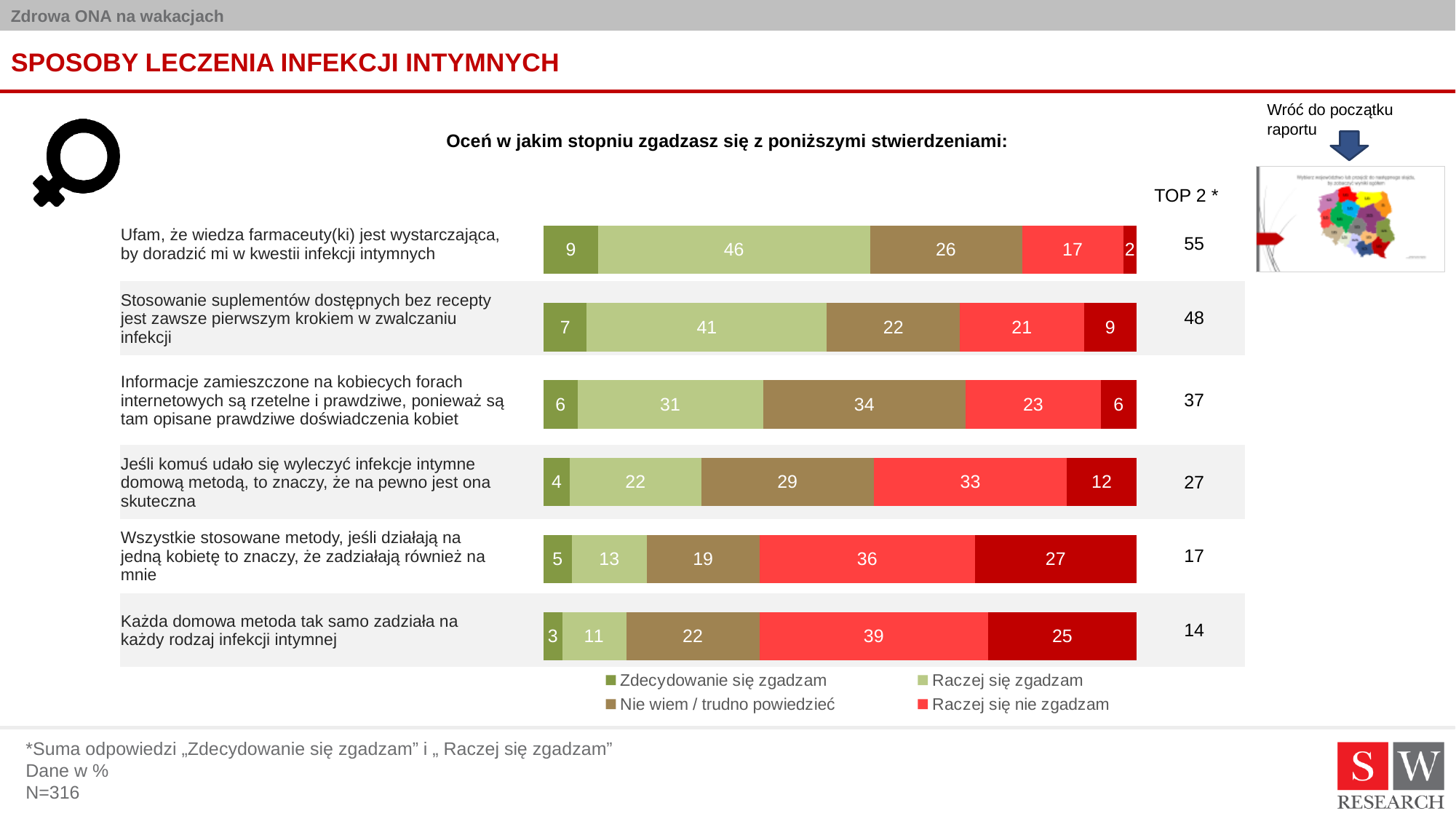
How many statements (categories) are plotted in the chart? 6 What is the 'Raczej się zgadzam' value for the statement 'Ufam, że wiedza farmaceuty(ki) jest wystarczająca, by doradzić mi w kwestii infekcji intymnych'? 46 What is the difference between the TOP 2 values of 'Ufam, że wiedza farmaceuty(ki)...' and 'Każda domowa metoda tak samo zadziała...'? 41 Which statement has the highest TOP 2 value? Ufam, że wiedza farmaceuty(ki) jest wystarczająca, by doradzić mi w kwestii infekcji intymnych What is the TOP 2 value for the statement 'Stosowanie suplementów dostępnych bez recepty jest zawsze pierwszym krokiem w zwalczaniu infekcji'? 48 What is the question shown as the chart title above the bars? Oceń w jakim stopniu zgadzasz się z poniższymi stwierdzeniami: What is the total of all segments in the bar for 'Jeśli komuś udało się wyleczyć infekcje intymne domową metodą...'? 100 What kind of chart is shown on the slide? Stacked bar chart Which is larger: the 'Raczej się nie zgadzam' value for 'Każda domowa metoda tak samo zadziała...' or for 'Wszystkie stosowane metody, jeśli działają na jedną kobietę...'? Każda domowa metoda tak samo zadziała na każdy rodzaj infekcji intymnej Which statement has the lowest TOP 2 value? Każda domowa metoda tak samo zadziała na każdy rodzaj infekcji intymnej What is the 'Nie wiem / trudno powiedzieć' value for the statement 'Informacje zamieszczone na kobiecych forach internetowych są rzetelne i prawdziwe...'? 34 How many series does the chart legend list? 4